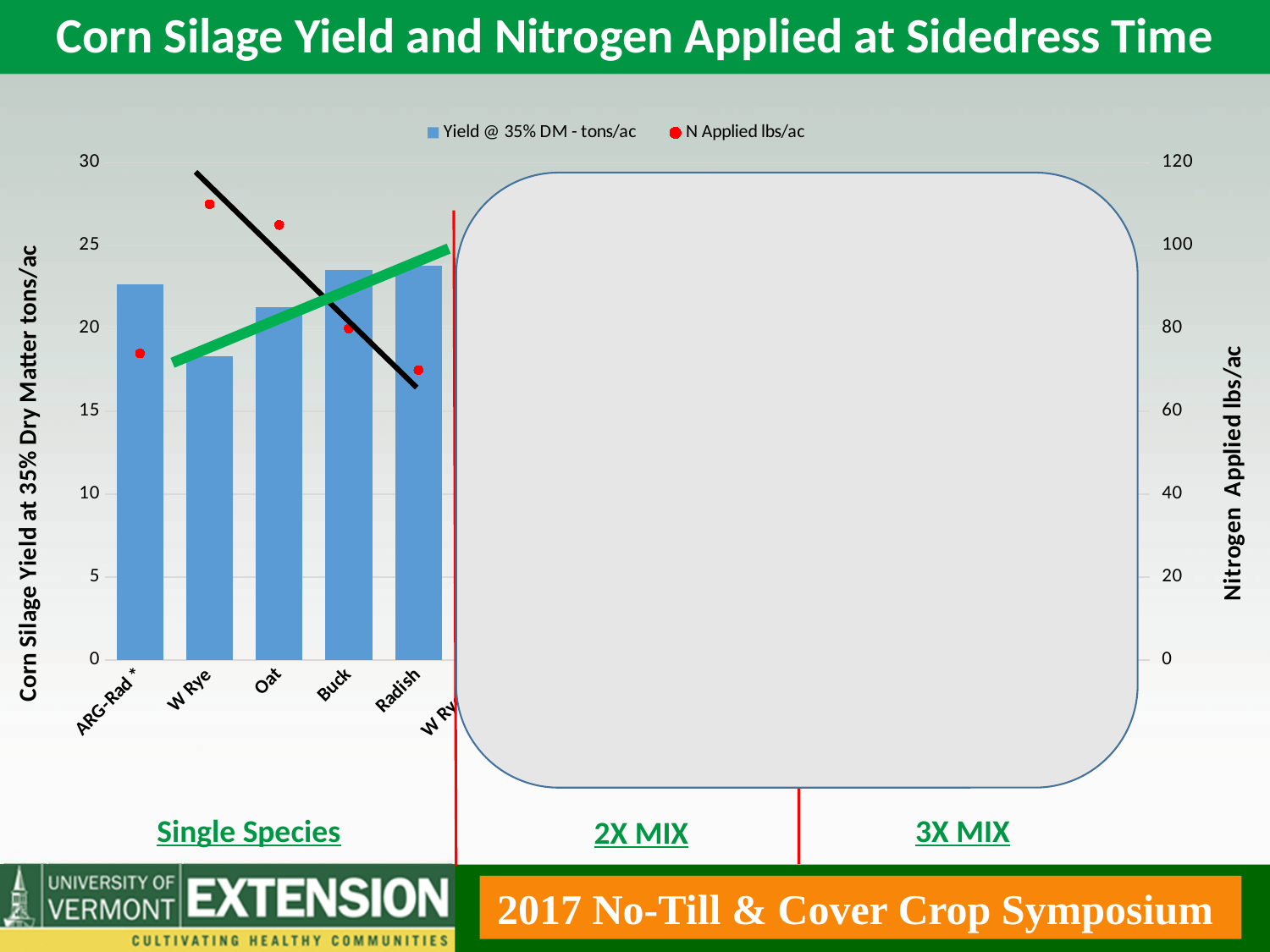
Is the yield value for Buck greater or less than 20? greater How many series does the chart legend list? 2 Is the yield value for W Rye greater or less than 20? less What are the two series named in the chart legend? Yield @ 35% DM - tons/ac; N Applied lbs/ac Is the N Applied value for W Rye greater or less than 100? greater Which has the larger yield bar, ARG-Rad * or W Rye? ARG-Rad * Which has the larger N Applied value, W Rye or Radish? W Rye What kind of chart is shown on the slide? bar chart (with a dot series on a secondary axis) What is the title of the right-hand vertical axis? Nitrogen Applied lbs/ac Of the five labeled single-species bars (ARG-Rad *, W Rye, Oat, Buck, Radish), which has the lowest yield? W Rye